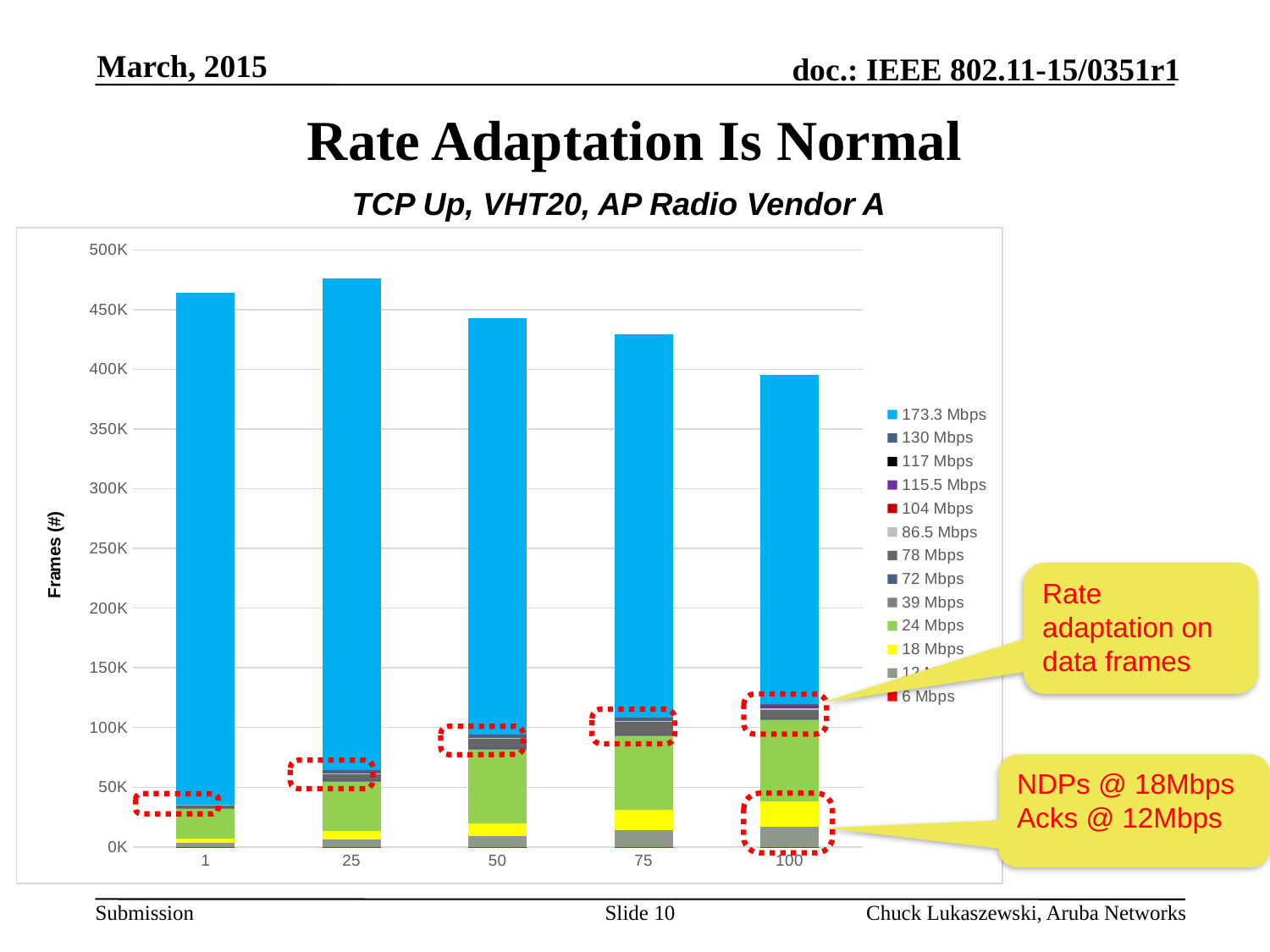
From category 25 to category 100, do the bar totals rise or fall? fall Which category has the shortest stacked bar? 100 What is the title of the chart? TCP Up, VHT20, AP Radio Vendor A Which category has the tallest stacked bar? 25 Is the total for category 75 greater or less than 400K? greater Which stacked bar is taller, category 1 or category 100? 1 How many series does the chart's legend list? 13 Is the total for category 25 greater or less than 450K? greater Is the total for category 50 greater or less than 450K? less How many categories are shown along the x axis of the chart? 5 What kind of chart is shown on the slide? Stacked bar chart